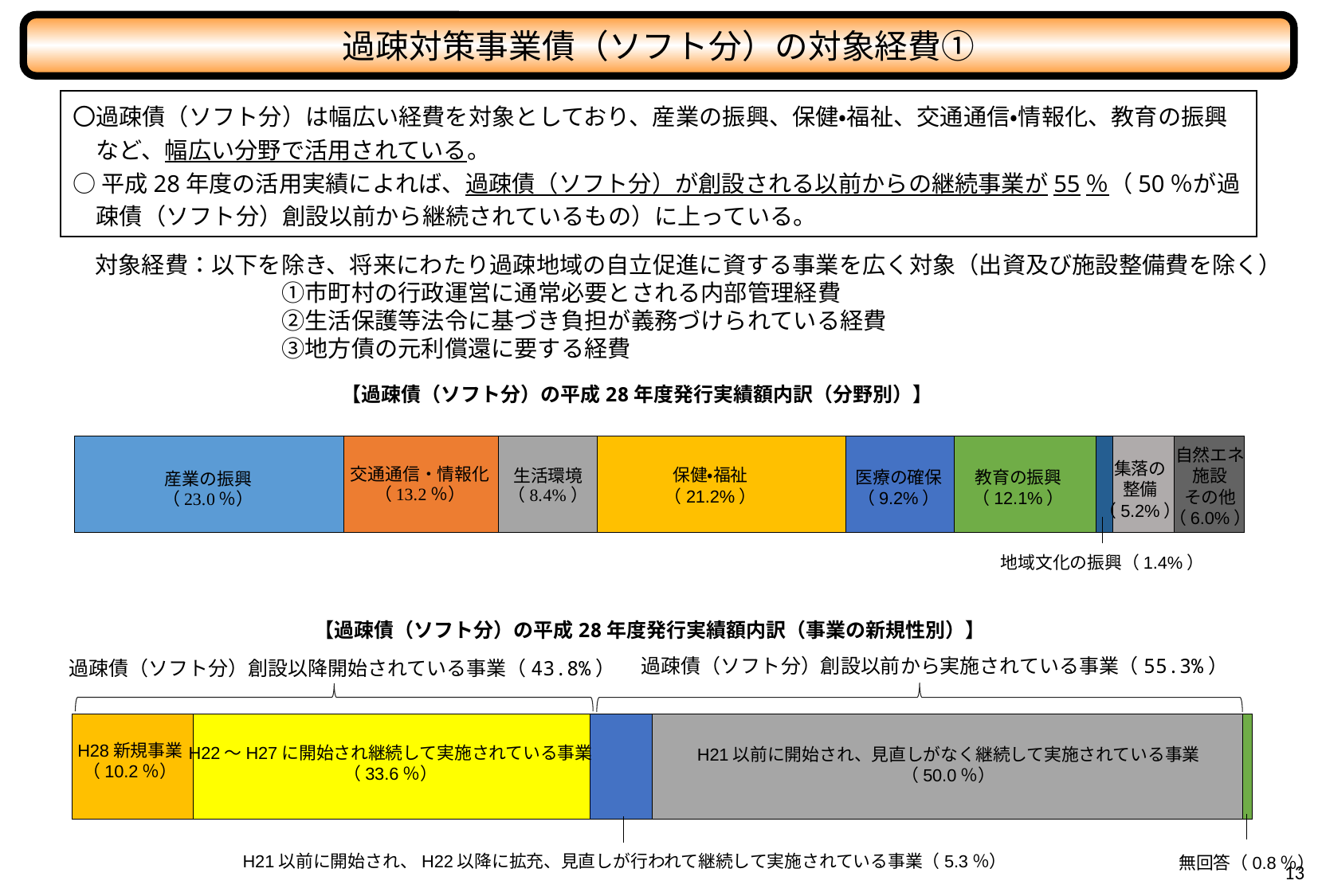
In the bottom chart (事業の新規性別), what is the combined share of projects started after the creation of 過疎債（ソフト分）? 43.8% How many segments are shown in the top chart (分野別)? 9 In the top chart (分野別), which is larger, 教育の振興 or 医療の確保? 教育の振興 In the bottom chart (事業の新規性別), what is the share for H28新規事業? 10.2% In the top chart (分野別), what is the difference between the shares of 産業の振興 and 交通通信・情報化? 9.8% In the top chart (分野別), which category has the largest share? 産業の振興 In the bottom chart (事業の新規性別), what is the share for H21以前に開始され、見直しがなく継続して実施されている事業? 50.0% In the top chart (分野別), what is the share for 保健・福祉? 21.2% In the top chart (分野別), which category has the smallest share? 地域文化の振興 What type of chart is used for the 分野別 breakdown? Stacked bar chart In the top chart (分野別), what is the share for 産業の振興? 23.0% In the bottom chart (事業の新規性別), what is the share for 無回答? 0.8%